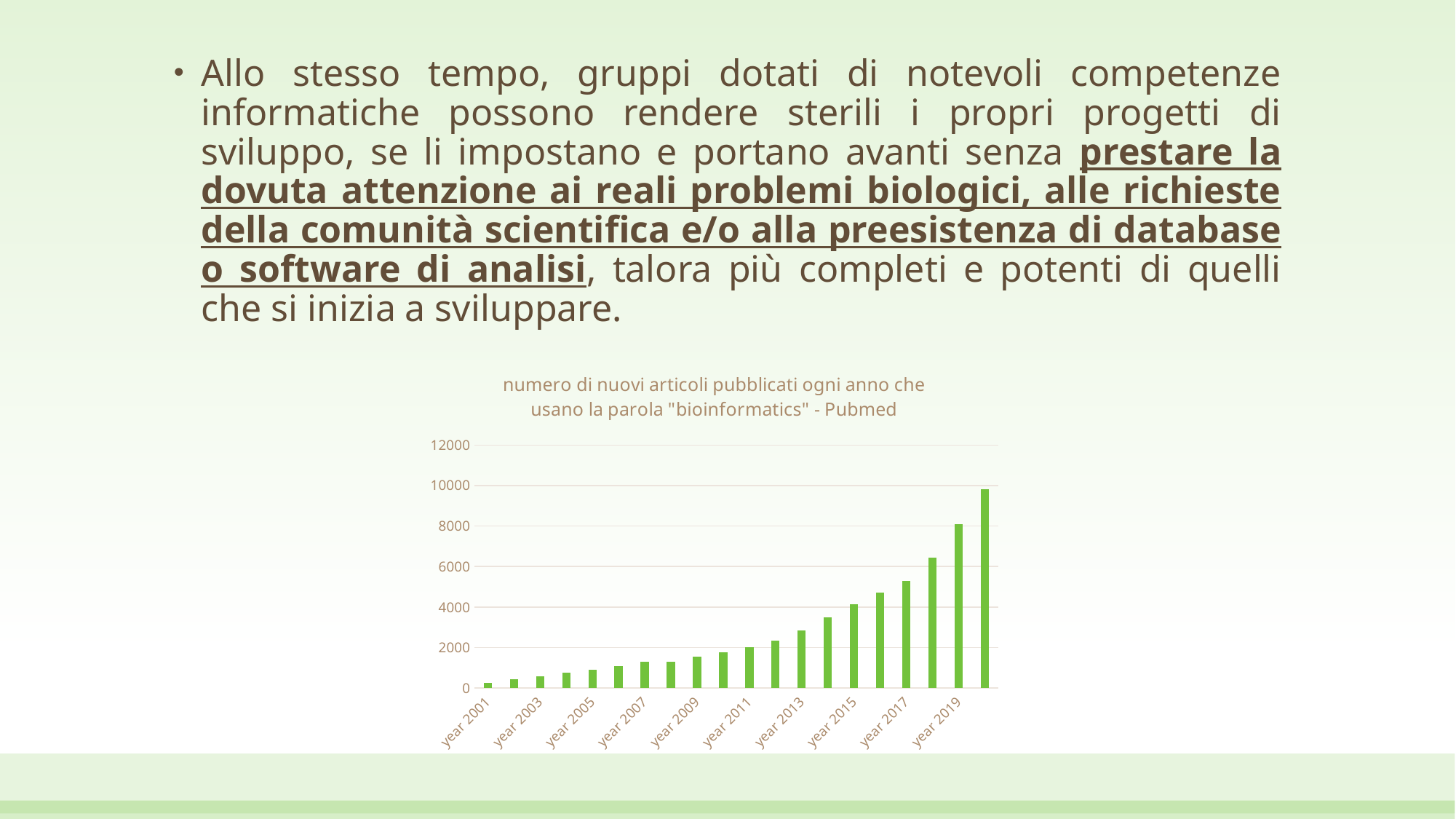
Do the values rise or fall from year 2001 to year 2020? rise Is the value for year 2013 greater or less than 4000? less Which is larger, the value for year 2009 or the value for year 2015? year 2015 What kind of chart is shown on the slide? bar chart Which year has the highest bar in the chart? year 2020 What colour are the bars in the chart? green Which year has the lowest bar in the chart? year 2001 Is the value for year 2017 greater or less than 4000? greater How many bars are plotted in the chart? 20 What is the title of the chart? numero di nuovi articoli pubblicati ogni anno che usano la parola "bioinformatics" - Pubmed Is the value for year 2018 greater or less than 6000? greater